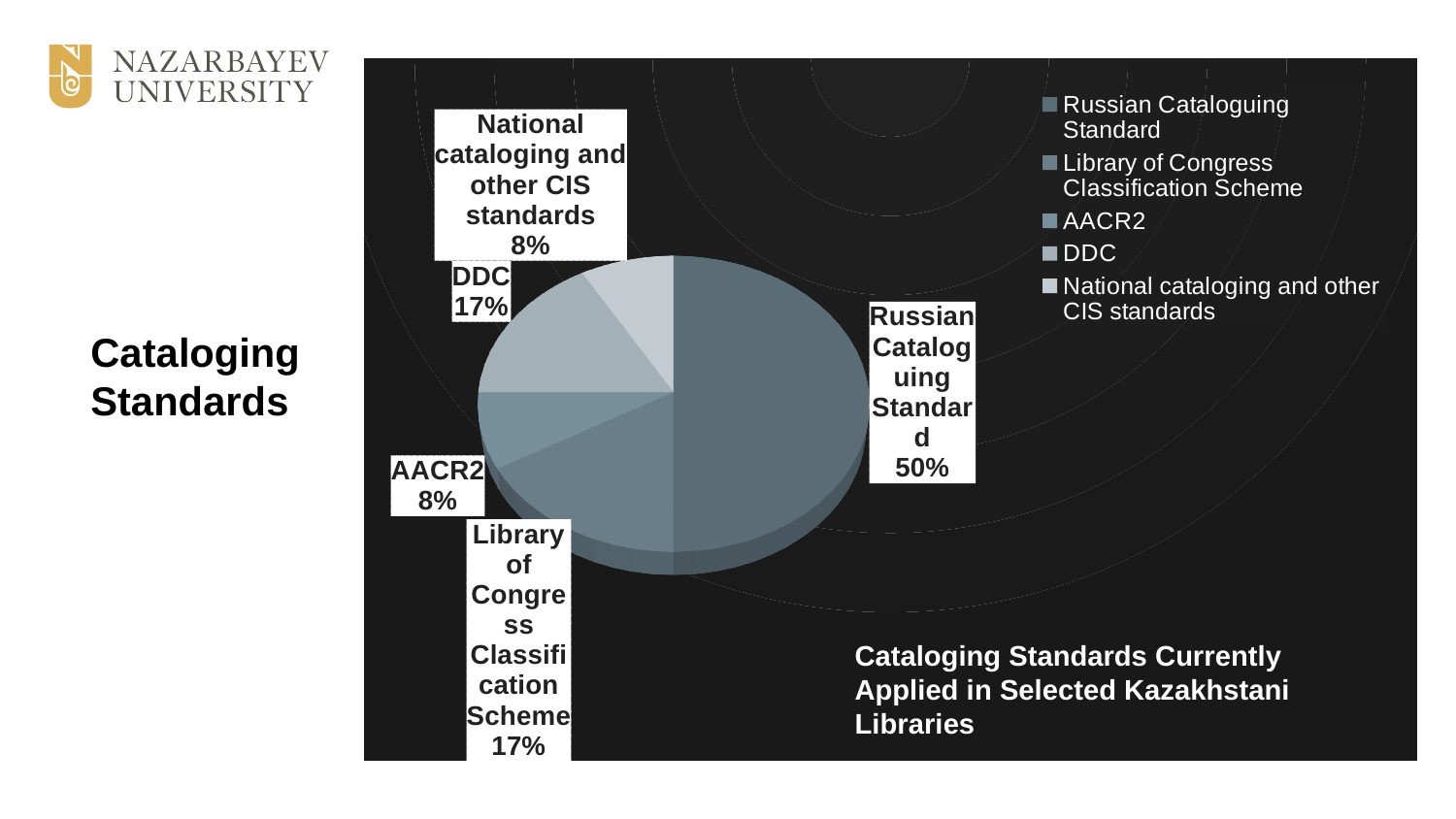
How many slices does the pie chart have? 5 Which is larger, the share for DDC or the share for AACR2? DDC What share of the pie does Library of Congress Classification Scheme have? 17% What kind of chart is shown on the slide? Pie chart What share of the pie does Russian Cataloguing Standard have? 50% How many entries does the legend list? 5 What share of the pie does National cataloging and other CIS standards have? 8% What is the difference in percentage points between Russian Cataloguing Standard and DDC? 33 What share of the pie does AACR2 have? 8% What share of the pie does DDC have? 17% What is the title of the chart? Cataloging Standards Currently Applied in Selected Kazakhstani Libraries Which category has the largest slice of the pie? Russian Cataloguing Standard